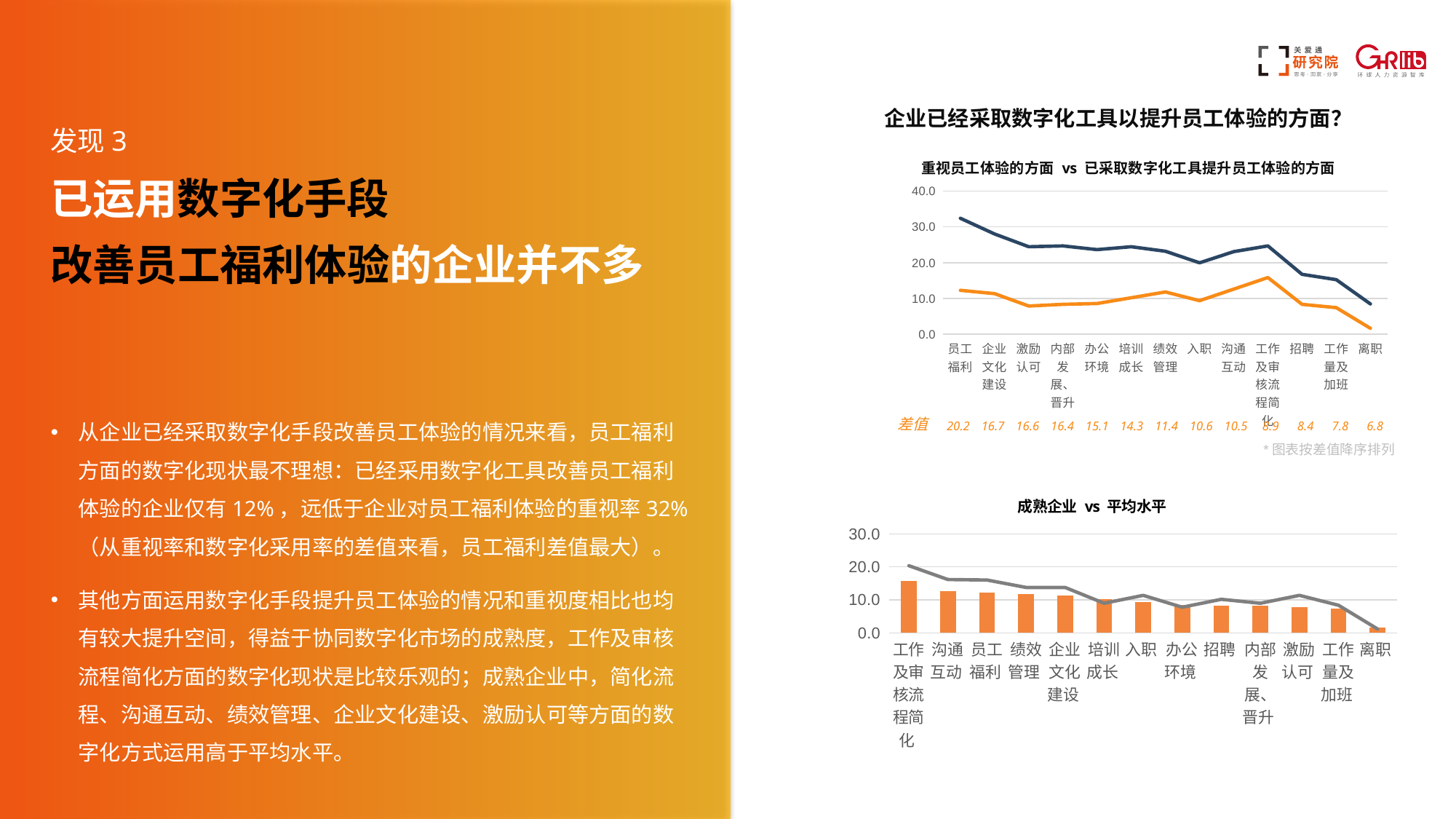
In the top chart, what is the 差值 value shown for 办公环境? 15.1 In the top chart, what is the 差值 value shown for 员工福利? 20.2 In the top chart, which category has the largest 差值? 员工福利 In the top chart, what is the difference between the 差值 for 企业文化建设 and the 差值 for 招聘? 8.3 In the bottom chart, do the bar values generally rise or fall from left to right along the x axis? fall How many bars are shown in the bottom chart titled 成熟企业 vs 平均水平? 13 In the bottom chart, which category has the tallest bar? 工作及审核流程简化 In the top chart, what is the 差值 value shown for 离职? 6.8 How many categories are shown on the x axis of the top chart? 13 What kind of chart is the top chart titled 重视员工体验的方面 vs 已采取数字化工具提升员工体验的方面? line chart In the top chart, is the value of the dark line for 员工福利 greater or less than 30? greater What kind of chart is the bottom chart titled 成熟企业 vs 平均水平? bar chart with a line